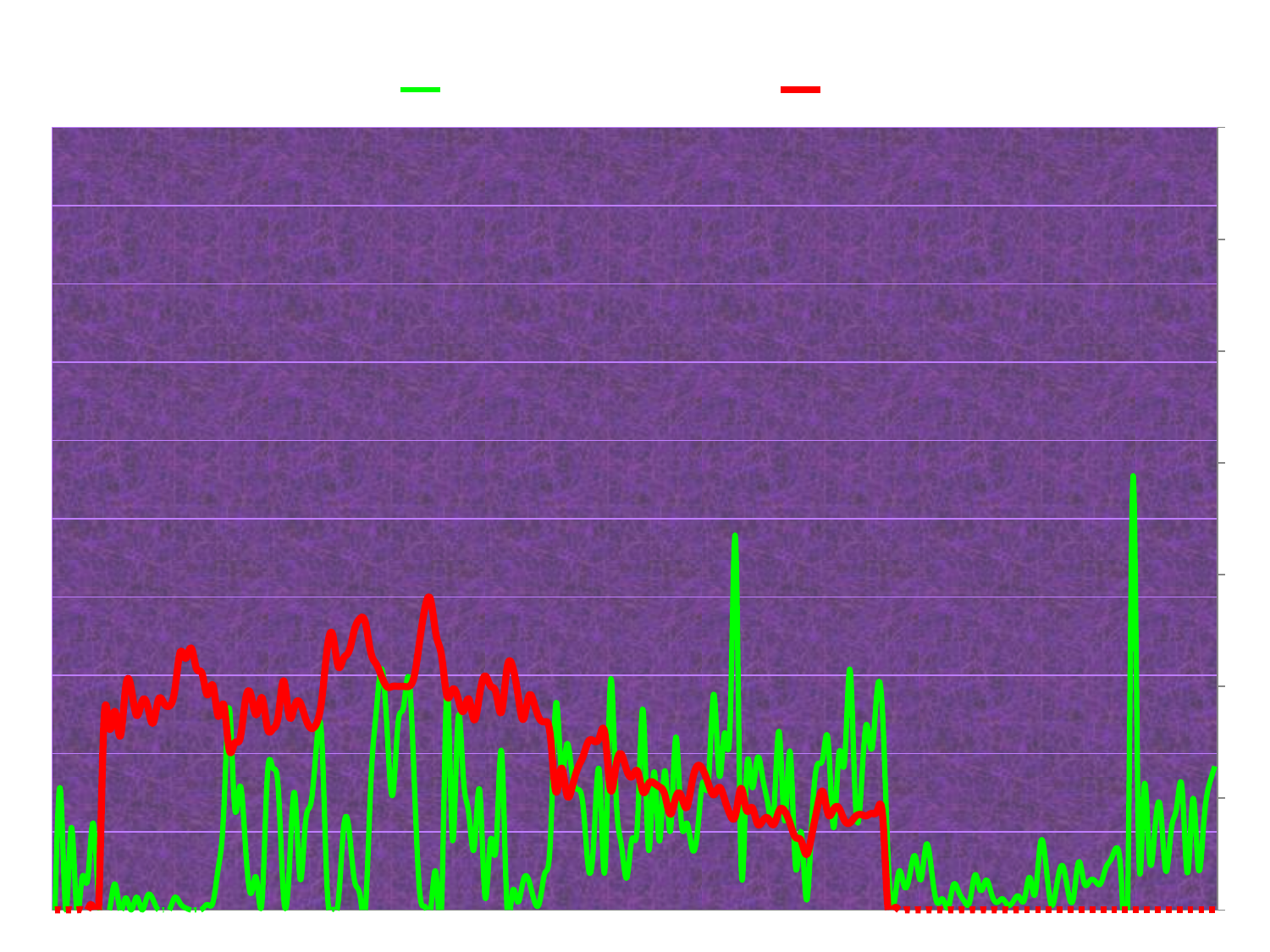
What colour is the chart's plot area background? purple What kind of chart is shown on the slide? line chart What colours are the two lines plotted on the chart? green and red How many series does the legend list? 2 Which series reaches the highest peak on the chart, the green line or the red line? the green line